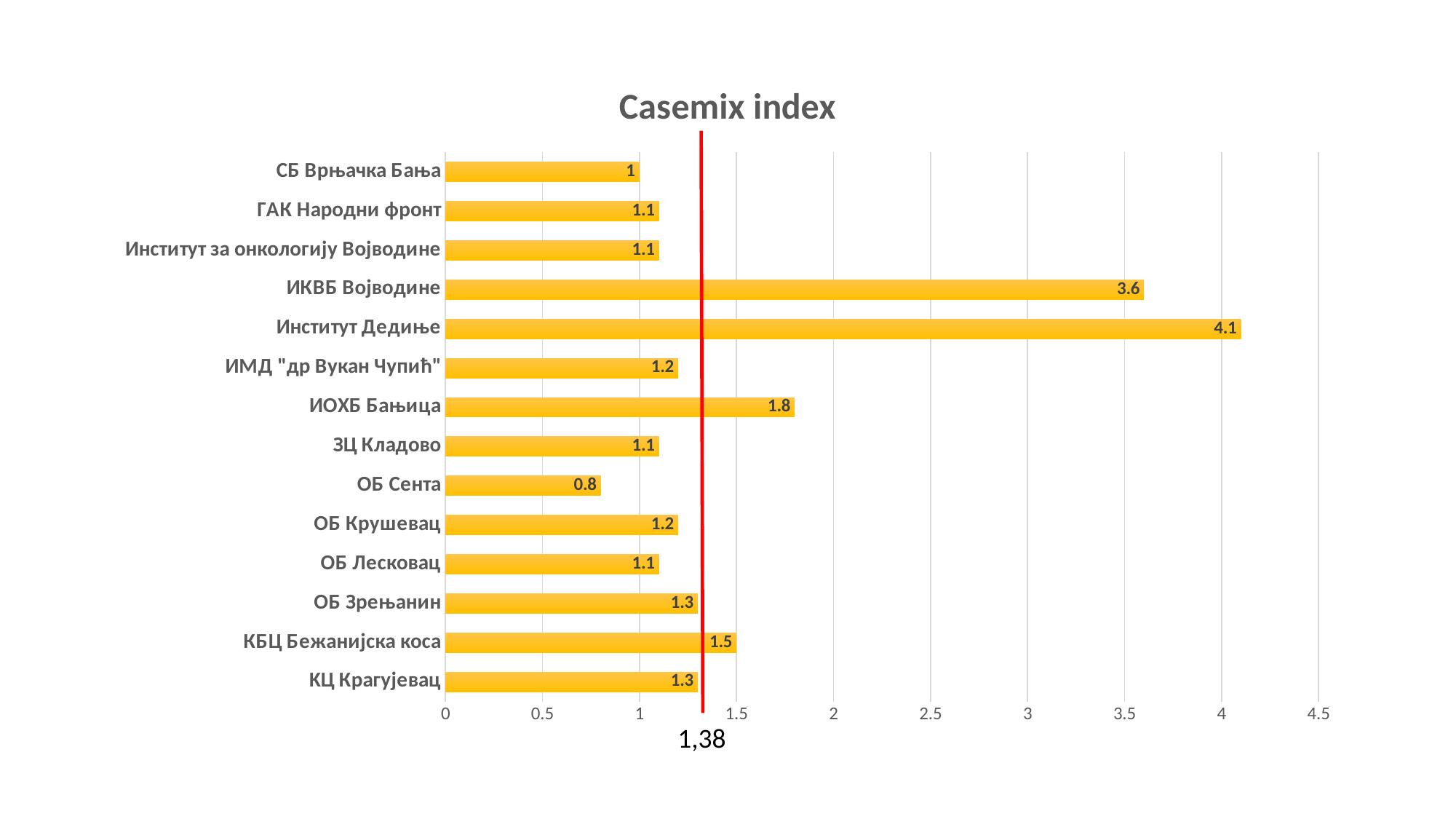
What is the difference between the Casemix index of Институт Дедиње and ИКВБ Војводине? 0.5 Which institution has the lowest Casemix index? ОБ Сента What is the Casemix index value for ИОХБ Бањица? 1.8 Which institution has the highest Casemix index? Институт Дедиње What type of chart is shown on the slide? Bar chart What value is marked by the red vertical line on the chart? 1,38 What is the title of the chart? Casemix index What is the Casemix index value for ОБ Сента? 0.8 What is the Casemix index value for КБЦ Бежанијска коса? 1.5 Which has a higher Casemix index, ИОХБ Бањица or ИМД "др Вукан Чупић"? ИОХБ Бањица How many institutions are shown in the chart? 14 What is the Casemix index value for Институт Дедиње? 4.1